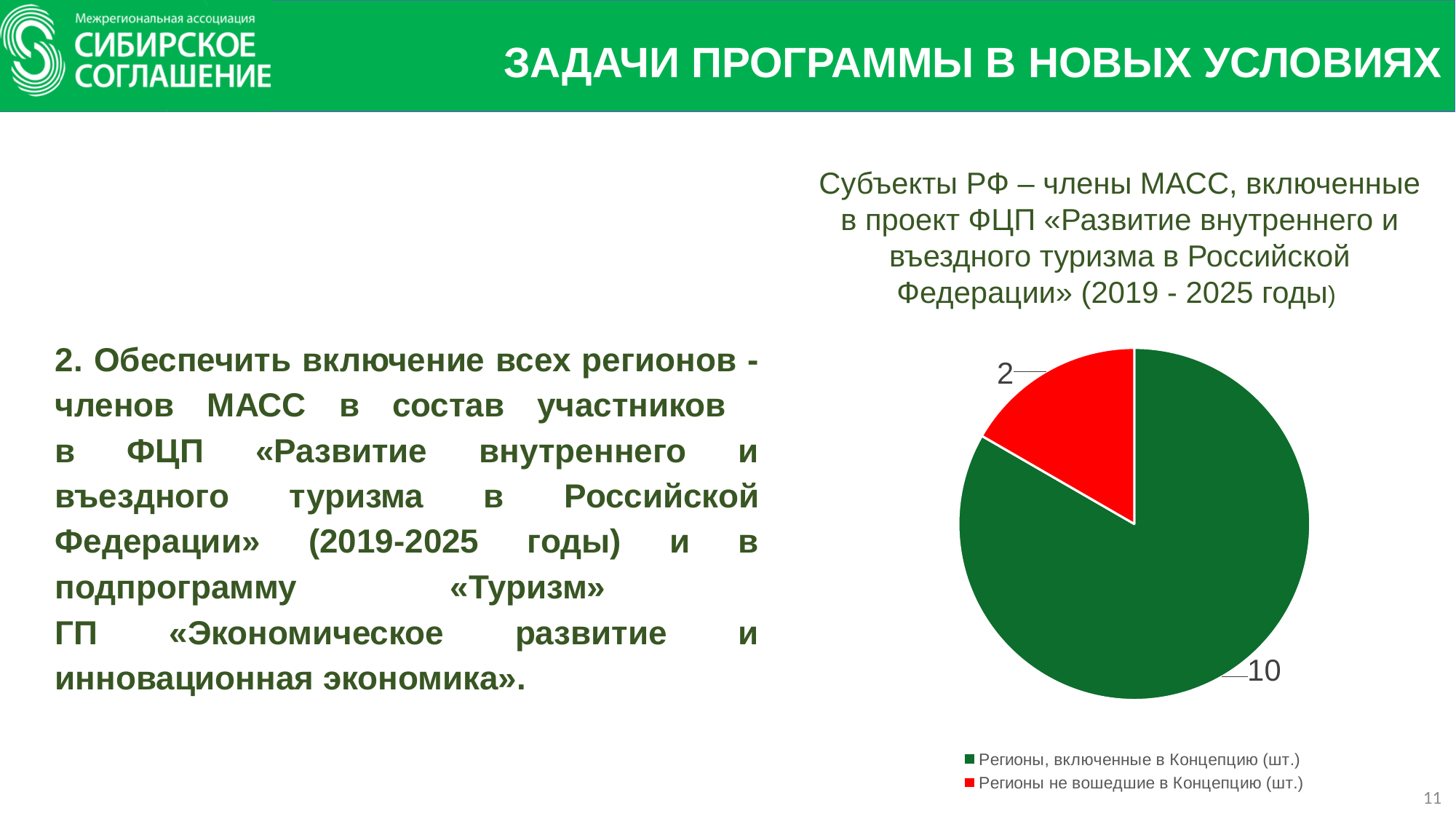
How many entries does the legend of the pie chart list? 2 How many regions are included in the Concept (Регионы, включенные в Концепцию) according to the pie chart? 10 Which is larger: the number of regions included in the Concept or the number not included? Регионы, включенные в Концепцию (шт.) What is the difference between the number of regions included in the Concept and the number not included? 8 What type of chart is shown on the slide? pie chart What is the total number of regions represented in the pie chart? 12 What colour is the slice for regions not included in the Concept? red Which category has the smallest slice in the pie chart? Регионы не вошедшие в Концепцию (шт.) How many slices does the pie chart have? 2 How many regions are not included in the Concept (Регионы не вошедшие в Концепцию) according to the pie chart? 2 What colour is the slice for regions included in the Concept? green Which category has the largest slice in the pie chart? Регионы, включенные в Концепцию (шт.)